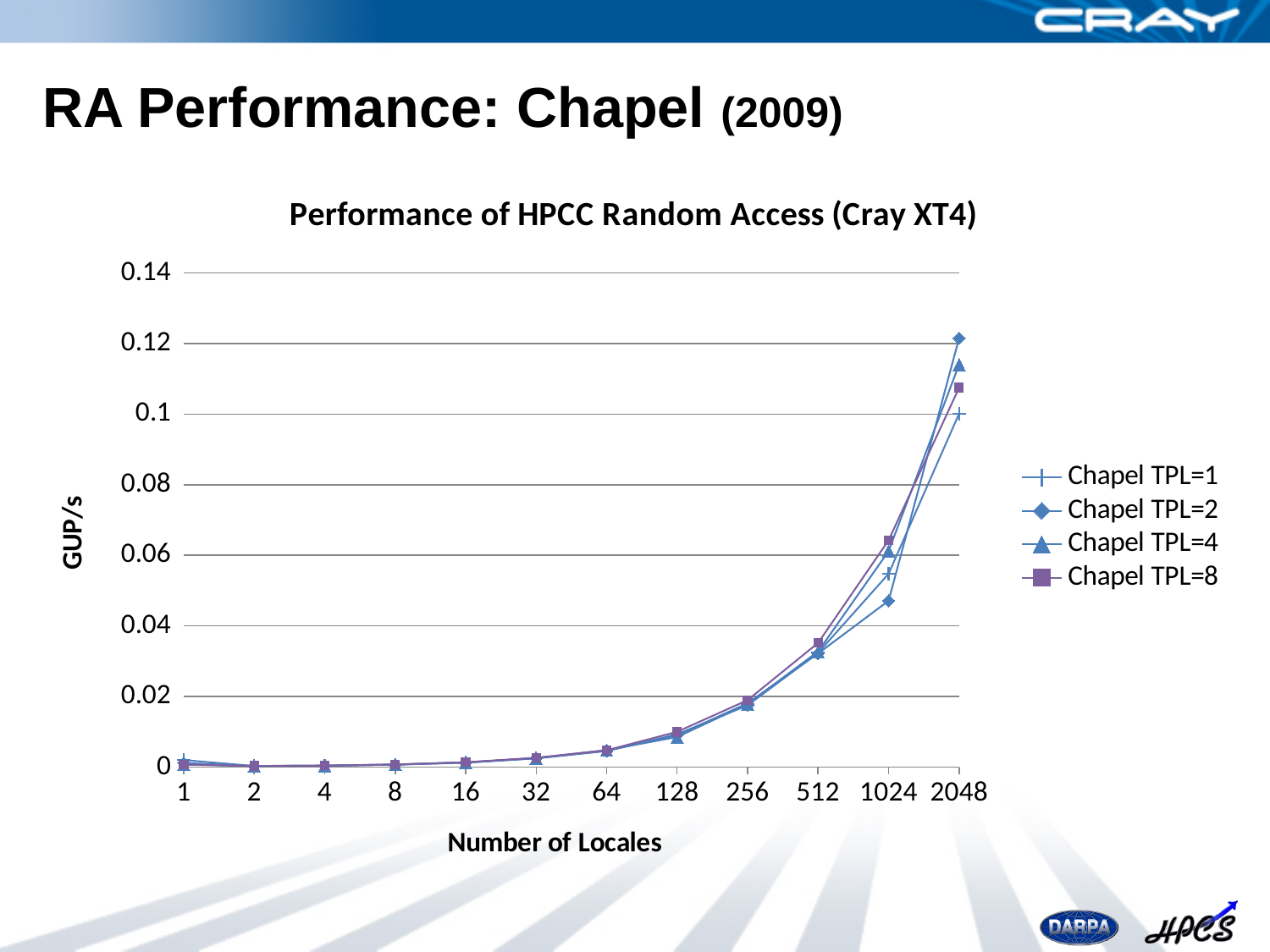
What kind of chart is shown on the slide? line chart Which series has the highest value at 2048 locales? Chapel TPL=2 Is the value for Chapel TPL=4 at 128 locales greater or less than 0.02? less Is the value for Chapel TPL=8 at 2048 locales greater or less than 0.1? greater What is the title of the chart? Performance of HPCC Random Access (Cray XT4) Which series has the lowest value at 2048 locales? Chapel TPL=1 Is the value for Chapel TPL=2 at 1024 locales greater or less than 0.06? less At 1024 locales, which is larger: Chapel TPL=8 or Chapel TPL=2? Chapel TPL=8 What is the label of the y axis? GUP/s Do the GUP/s values rise or fall as the number of locales increases? rise How many series does the legend list? 4 How many points are on the x axis (Number of Locales)? 12